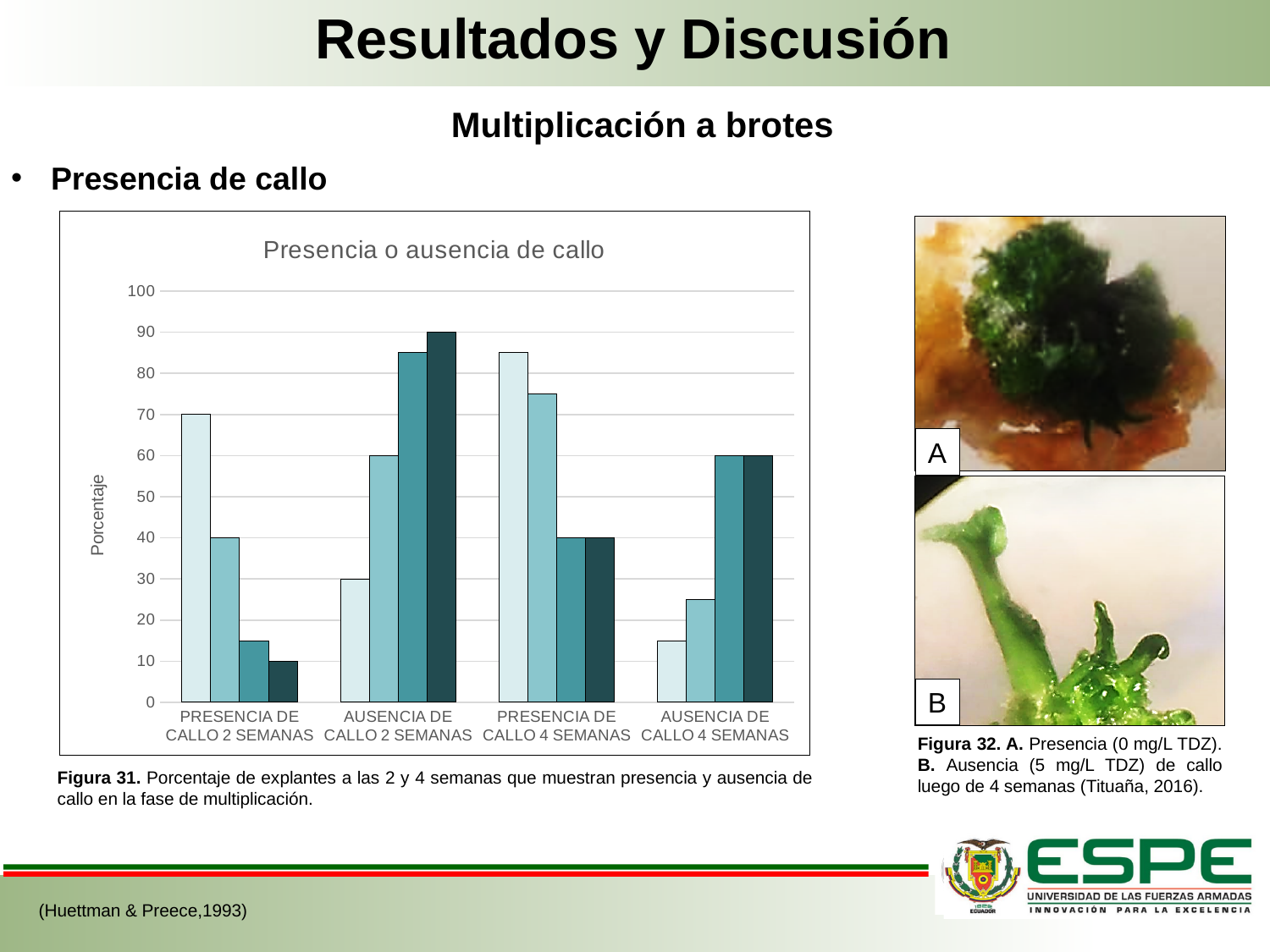
How many categories are shown on the x axis of the chart? 4 In the 'Ausencia de callo 2 semanas' category, which is larger: the lightest (first) bar or the darkest (last) bar? the darkest (last) bar How many bars are plotted for each category in the chart? 4 Within the 'Presencia de callo 2 semanas' category, do the bars rise or fall from left to right? fall What is the value of the lightest (first) bar in the 'Presencia de callo 2 semanas' category? 70 What is the label of the vertical axis of the chart? Porcentaje What is the value of the darkest (last) bar in the 'Ausencia de callo 2 semanas' category? 90 What is the value of the darkest (last) bar in the 'Presencia de callo 2 semanas' category? 10 What is the title of the chart? Presencia o ausencia de callo Is the value of the lightest (first) bar in the 'Ausencia de callo 4 semanas' category greater or less than 20? less What kind of chart is shown on the slide? bar chart Is the value of the lightest (first) bar in the 'Presencia de callo 4 semanas' category greater or less than 80? greater